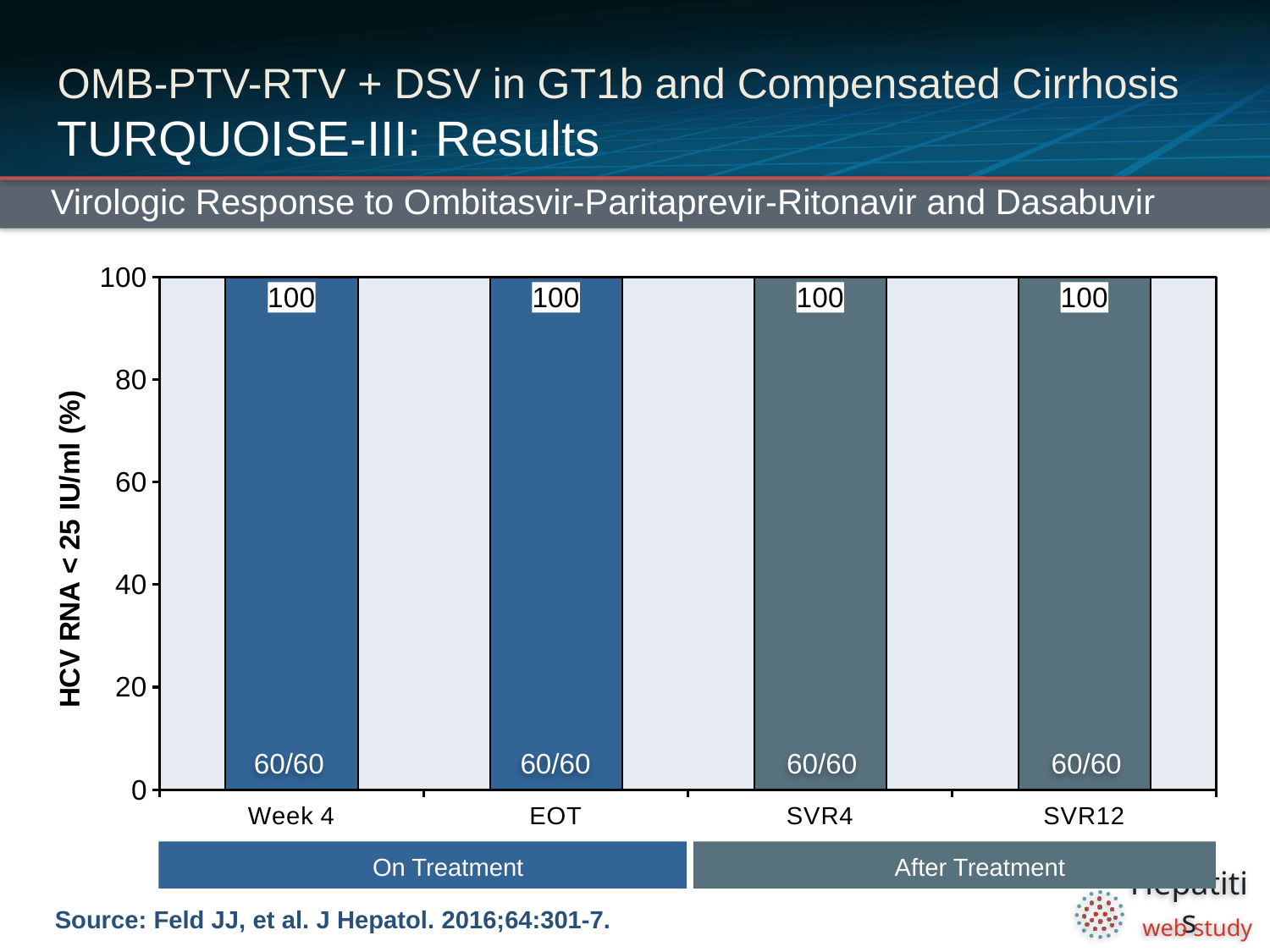
What is the value for EOT? 100 Do the values rise, fall, or stay the same from Week 4 to SVR12? Stay the same What fraction of patients is shown inside the SVR12 bar? 60/60 Which two time points are grouped under "After Treatment"? SVR4 and SVR12 What is the value for Week 4? 100 What is the value for SVR12? 100 What fraction of patients is shown inside the Week 4 bar? 60/60 What is the value for SVR4? 100 What kind of chart is shown? Bar chart What is the label of the y axis? HCV RNA < 25 IU/ml (%) How many categories are shown on the x axis? 4 What is the difference between the values for Week 4 and SVR12? 0